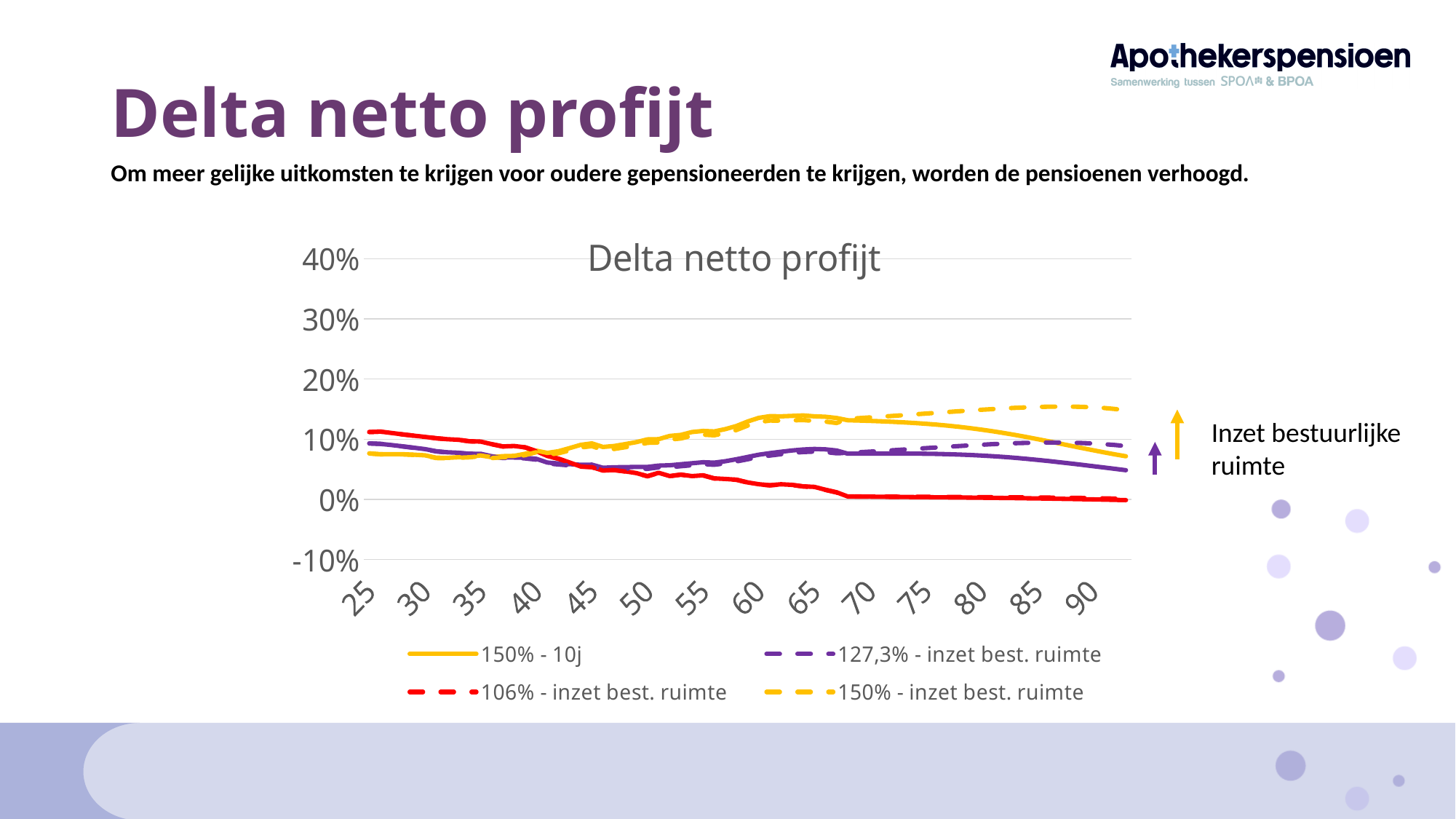
Is the value of the '150% - inzet best. ruimte' series at age 85 greater or less than 10%? greater How many series does the legend of the chart list? 4 At age 90, which is larger: the '150% - inzet best. ruimte' series or the '127,3% - inzet best. ruimte' series? 150% - inzet best. ruimte What kind of chart is shown on the slide? line chart Does the value of the '106% - inzet best. ruimte' series rise or fall from age 25 to age 90? fall What is the title of the chart? Delta netto profijt How many age labels are shown on the x axis of the chart? 14 Which series has the highest value at age 85? 150% - inzet best. ruimte Is the value of the '106% - inzet best. ruimte' series at age 25 greater or less than 10%? greater Which series is drawn as a red dashed line? 106% - inzet best. ruimte